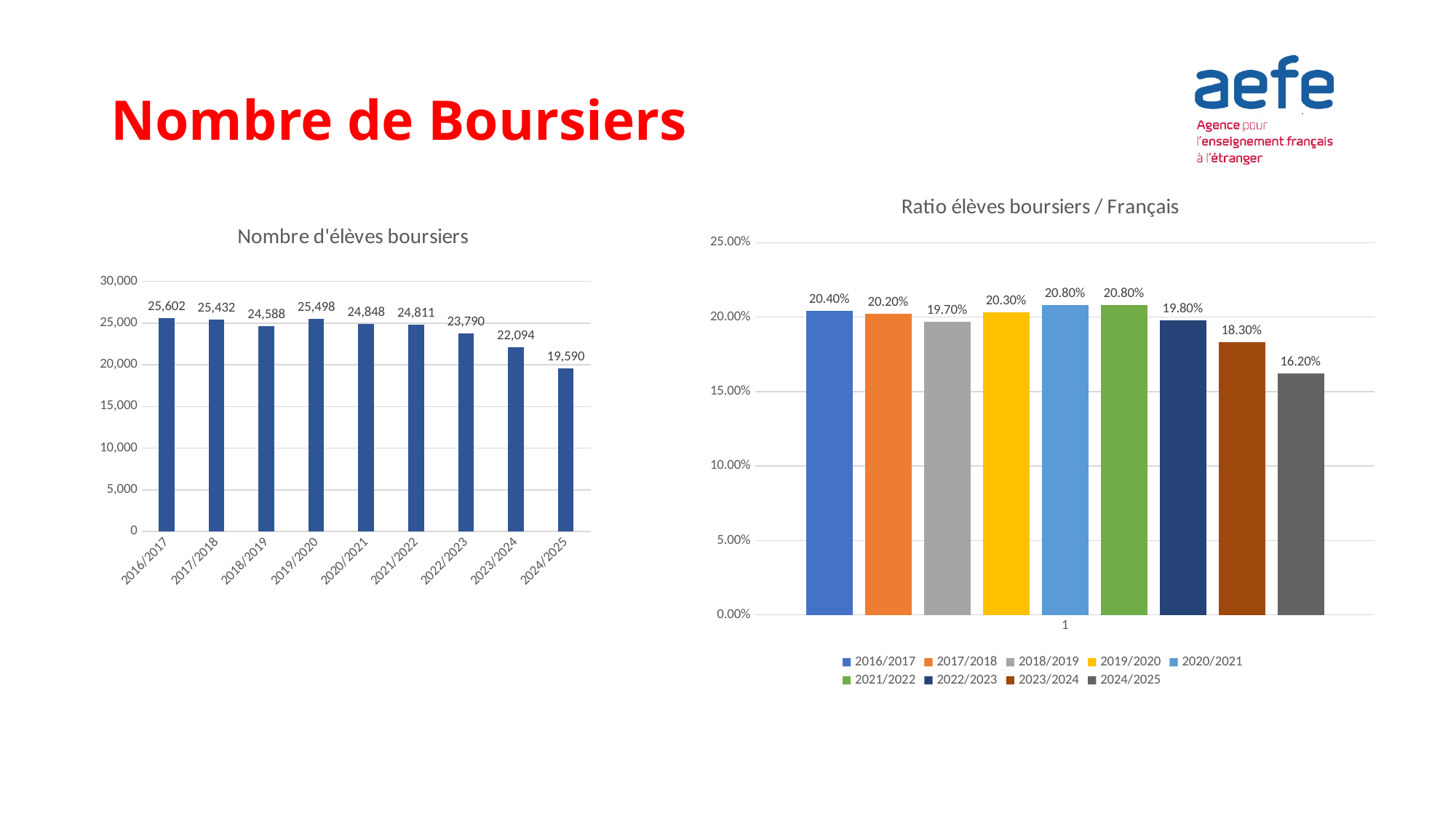
In the 'Ratio élèves boursiers / Français' chart, is the value for 2022/2023 larger or smaller than the value for 2023/2024? larger In the 'Ratio élèves boursiers / Français' chart, which year has the lowest value? 2024/2025 What kind of chart is 'Nombre d'élèves boursiers'? bar chart In the 'Ratio élèves boursiers / Français' chart, what is the value for 2023/2024? 18.30% In the 'Nombre d'élèves boursiers' chart, which year has the highest value? 2016/2017 In the 'Nombre d'élèves boursiers' chart, what is the value for 2016/2017? 25,602 In the 'Nombre d'élèves boursiers' chart, which year has the lowest value? 2024/2025 In the 'Nombre d'élèves boursiers' chart, how many years are shown on the x axis? 9 In the 'Ratio élèves boursiers / Français' chart, what is the value for 2018/2019? 19.70% In the 'Nombre d'élèves boursiers' chart, what is the difference between the values for 2023/2024 and 2024/2025? 2,504 In the 'Ratio élèves boursiers / Français' chart, how many series does the legend list? 9 In the 'Nombre d'élèves boursiers' chart, what is the value for 2024/2025? 19,590